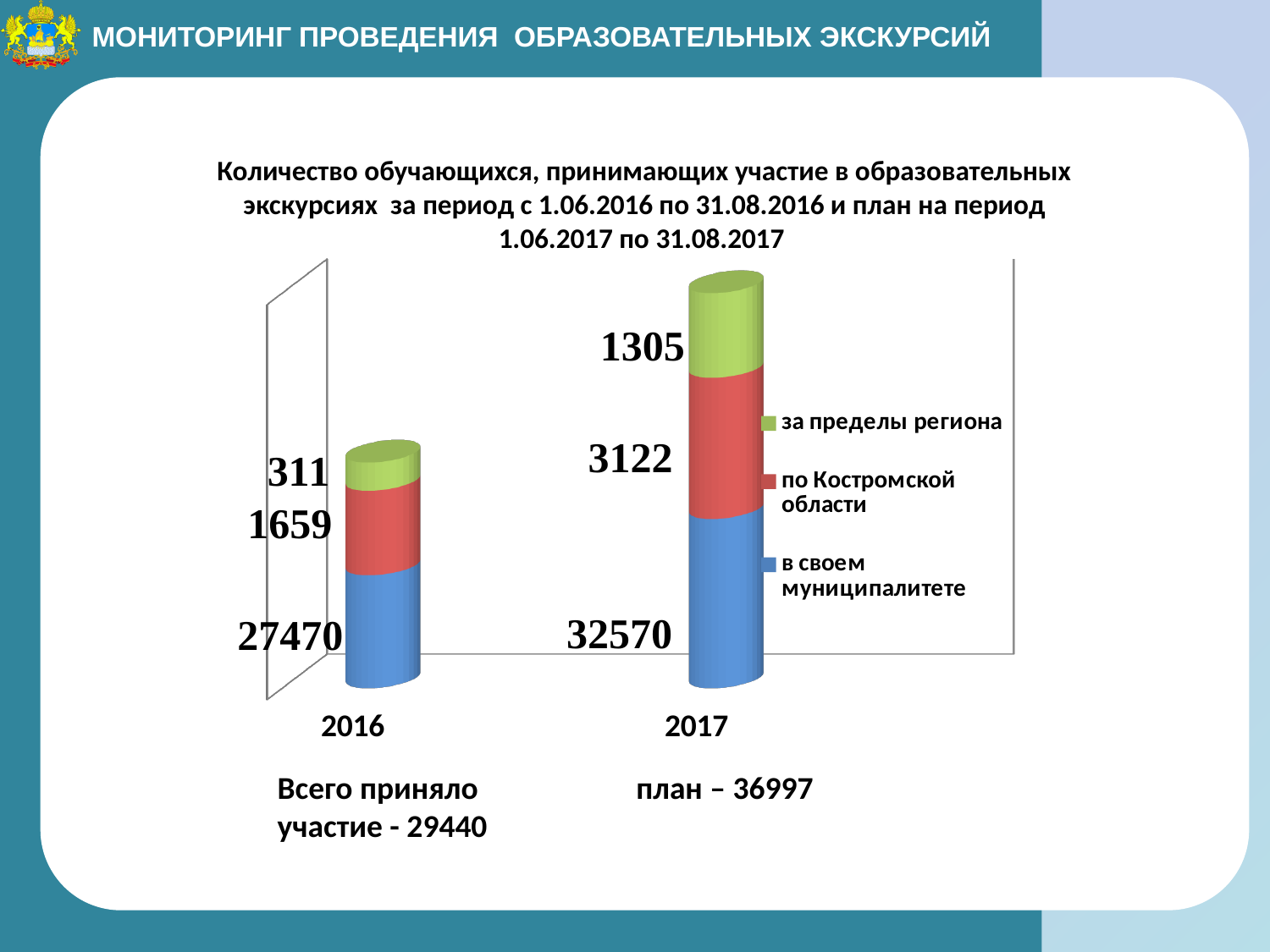
What is the value for "по Костромской области" in 2017? 3122 What is the value for "по Костромской области" in 2016? 1659 What is the value for "за пределы региона" in 2016? 311 How many categories are shown on the x axis? 2 How many series does the legend list? 3 What is the total of the stacked bar for 2017? 36997 What kind of chart is shown on the slide? Stacked bar chart What is the total of the stacked bar for 2016? 29440 What is the difference between the "в своем муниципалитете" values for 2017 and 2016? 5100 What is the value for "в своем муниципалитете" in 2016? 27470 Which year has the larger value for "за пределы региона", 2016 or 2017? 2017 What is the value for "за пределы региона" in 2017? 1305